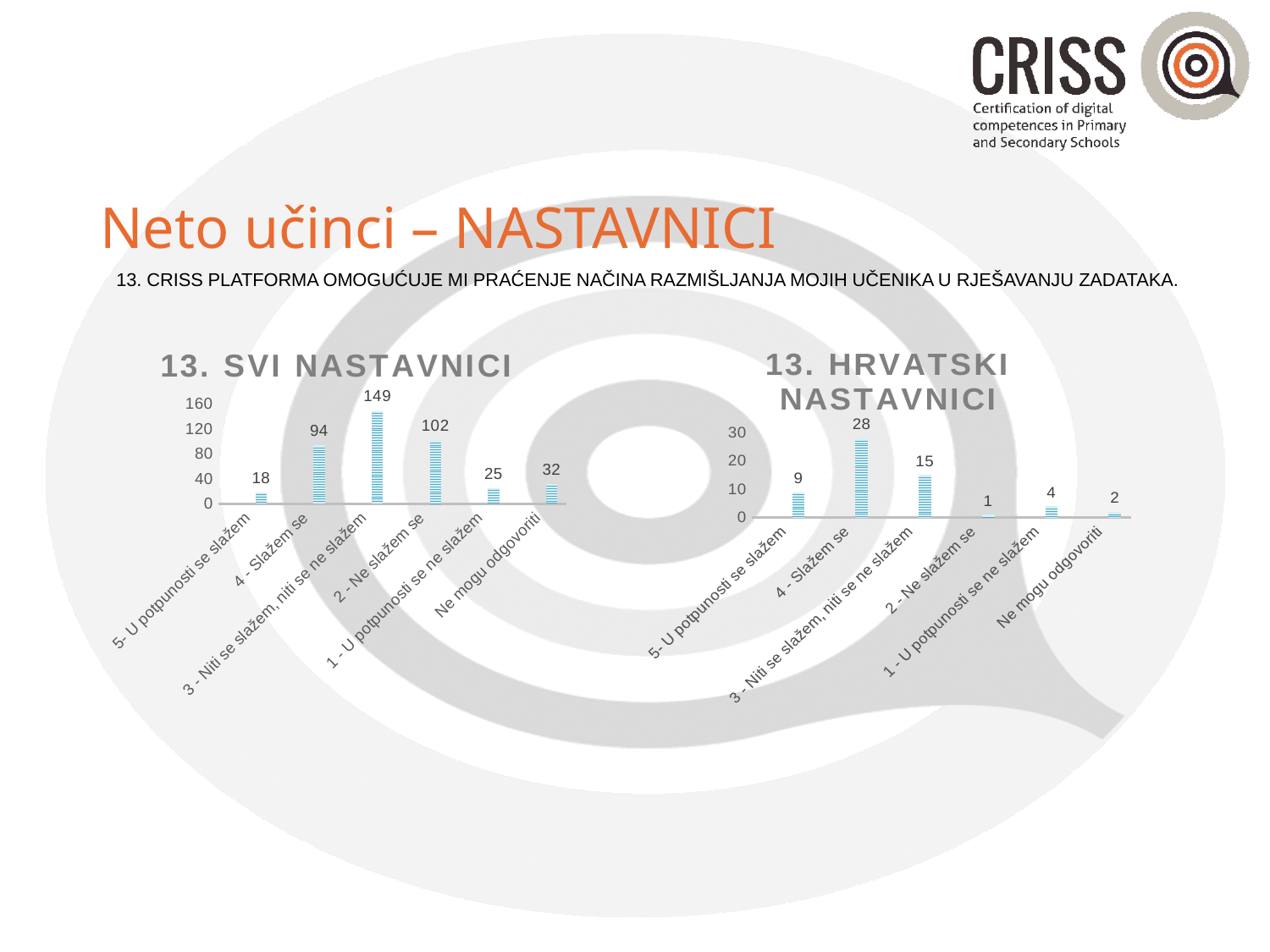
In the '13. SVI NASTAVNICI' chart, how many categories are shown on the x axis? 6 In the '13. SVI NASTAVNICI' chart, what is the value for '4 - Slažem se'? 94 In the '13. HRVATSKI NASTAVNICI' chart, what is the difference between the values for '4 - Slažem se' and '5- U potpunosti se slažem'? 19 In the '13. SVI NASTAVNICI' chart, which category has the highest value? 3 - Niti se slažem, niti se ne slažem What kind of chart is the '13. SVI NASTAVNICI' chart? Bar chart In the '13. SVI NASTAVNICI' chart, what is the difference between the values for '2 - Ne slažem se' and '4 - Slažem se'? 8 In the '13. HRVATSKI NASTAVNICI' chart, what is the value for '2 - Ne slažem se'? 1 In the '13. HRVATSKI NASTAVNICI' chart, which category has the lowest value? 2 - Ne slažem se In the '13. HRVATSKI NASTAVNICI' chart, which is larger: the value for '5- U potpunosti se slažem' or the value for 'Ne mogu odgovoriti'? 5- U potpunosti se slažem In the '13. SVI NASTAVNICI' chart, is the value for '3 - Niti se slažem, niti se ne slažem' greater or less than 120? greater In the '13. HRVATSKI NASTAVNICI' chart, which category has the highest value? 4 - Slažem se In the '13. SVI NASTAVNICI' chart, which category has the lowest value? 5- U potpunosti se slažem